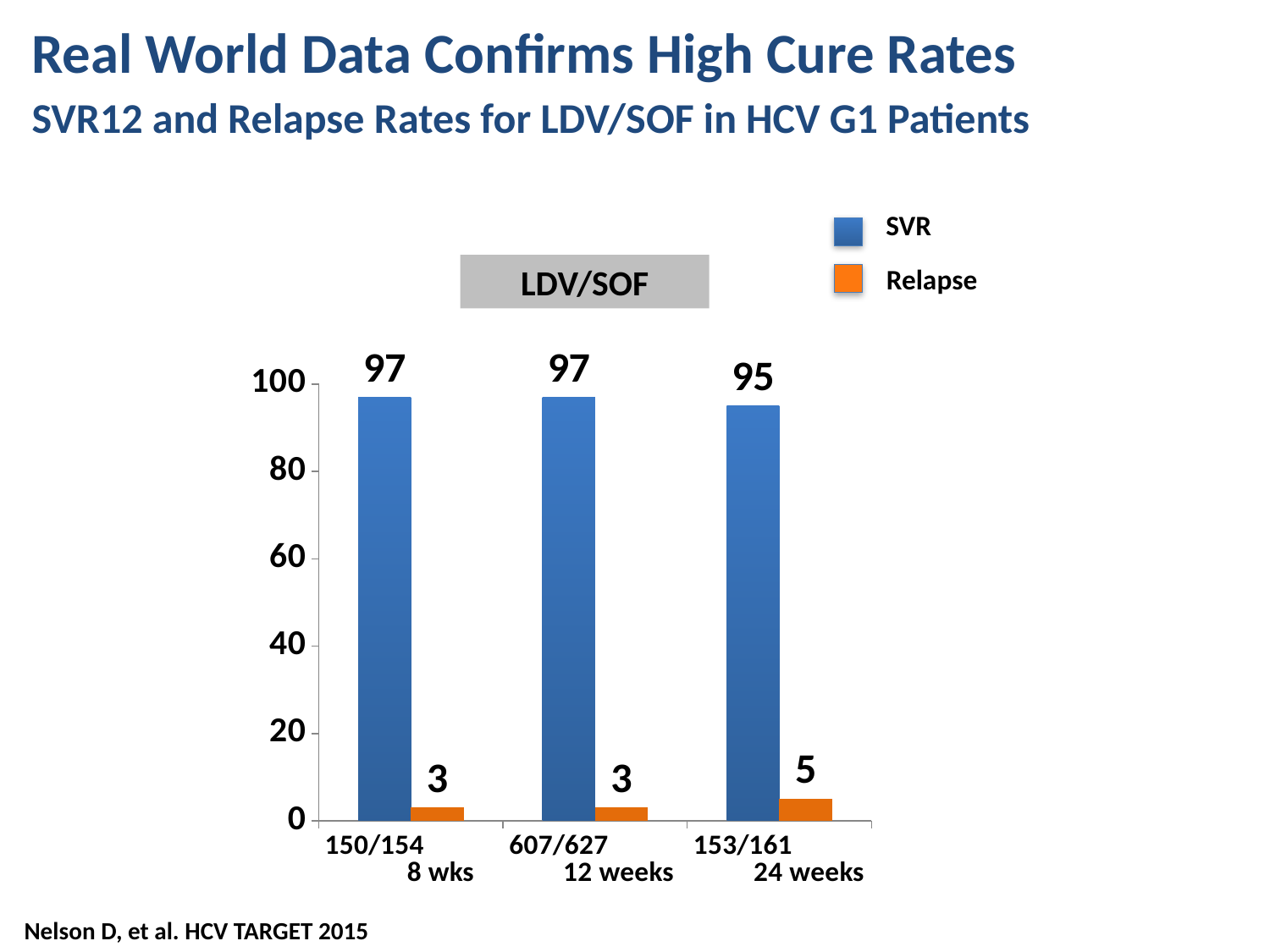
Which treatment duration has the lowest SVR value? 24 weeks Which treatment duration has the highest Relapse value? 24 weeks What is the Relapse value for the 12 weeks group? 3 What colour are the Relapse bars? orange How many series does the legend list? 2 What is the Relapse value for the 24 weeks group? 5 What is the SVR value for the 24 weeks group? 95 What is the SVR value for the 8 wks group? 97 How many treatment duration groups are shown on the x axis? 3 What is the difference between the SVR value for 8 wks and the SVR value for 24 weeks? 2 What kind of chart is shown on the slide? bar chart Is the Relapse value for 24 weeks larger or smaller than the Relapse value for 12 weeks? larger